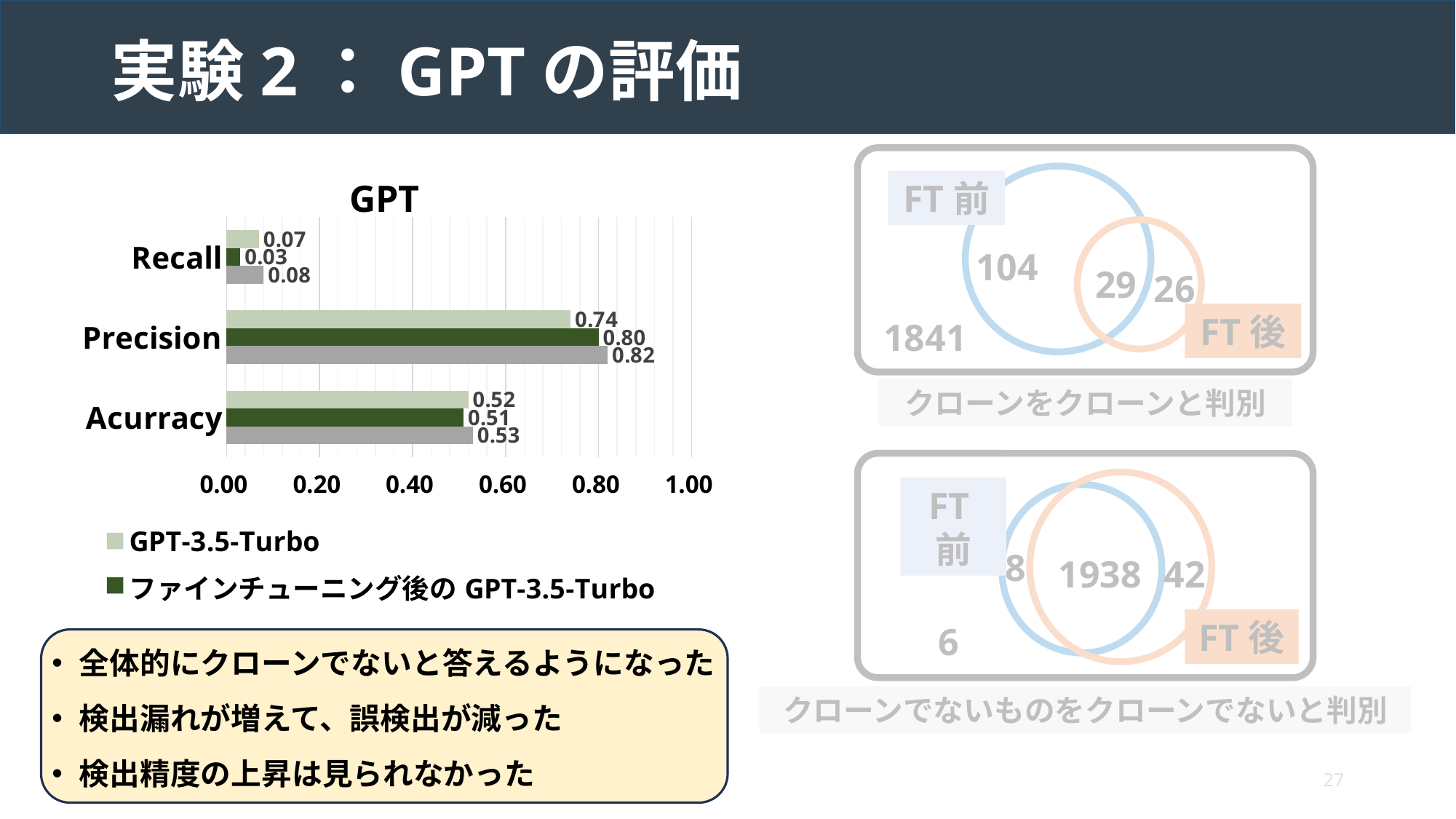
In the GPT chart, what is the Acurracy value for GPT-3.5-Turbo? 0.52 How many metric categories are shown on the y axis of the GPT chart? 3 In the GPT chart, which metric has the lowest value for ファインチューニング後の GPT-3.5-Turbo? Recall In the GPT chart, how much higher is the Precision of ファインチューニング後の GPT-3.5-Turbo than that of GPT-3.5-Turbo? 0.06 In the GPT chart, what is the Recall value for ファインチューニング後の GPT-3.5-Turbo? 0.03 What type of chart is the GPT chart? Bar chart In the GPT chart, what is the Precision value for GPT-3.5-Turbo? 0.74 How many series does the legend of the GPT chart list? 2 In the GPT chart, which has the higher Recall: GPT-3.5-Turbo or ファインチューニング後の GPT-3.5-Turbo? GPT-3.5-Turbo In the GPT chart, what is the Precision value for ファインチューニング後の GPT-3.5-Turbo? 0.80 In the GPT chart, what is the difference between the Recall of GPT-3.5-Turbo and the Recall of ファインチューニング後の GPT-3.5-Turbo? 0.04 In the GPT chart, which metric has the highest value for GPT-3.5-Turbo? Precision